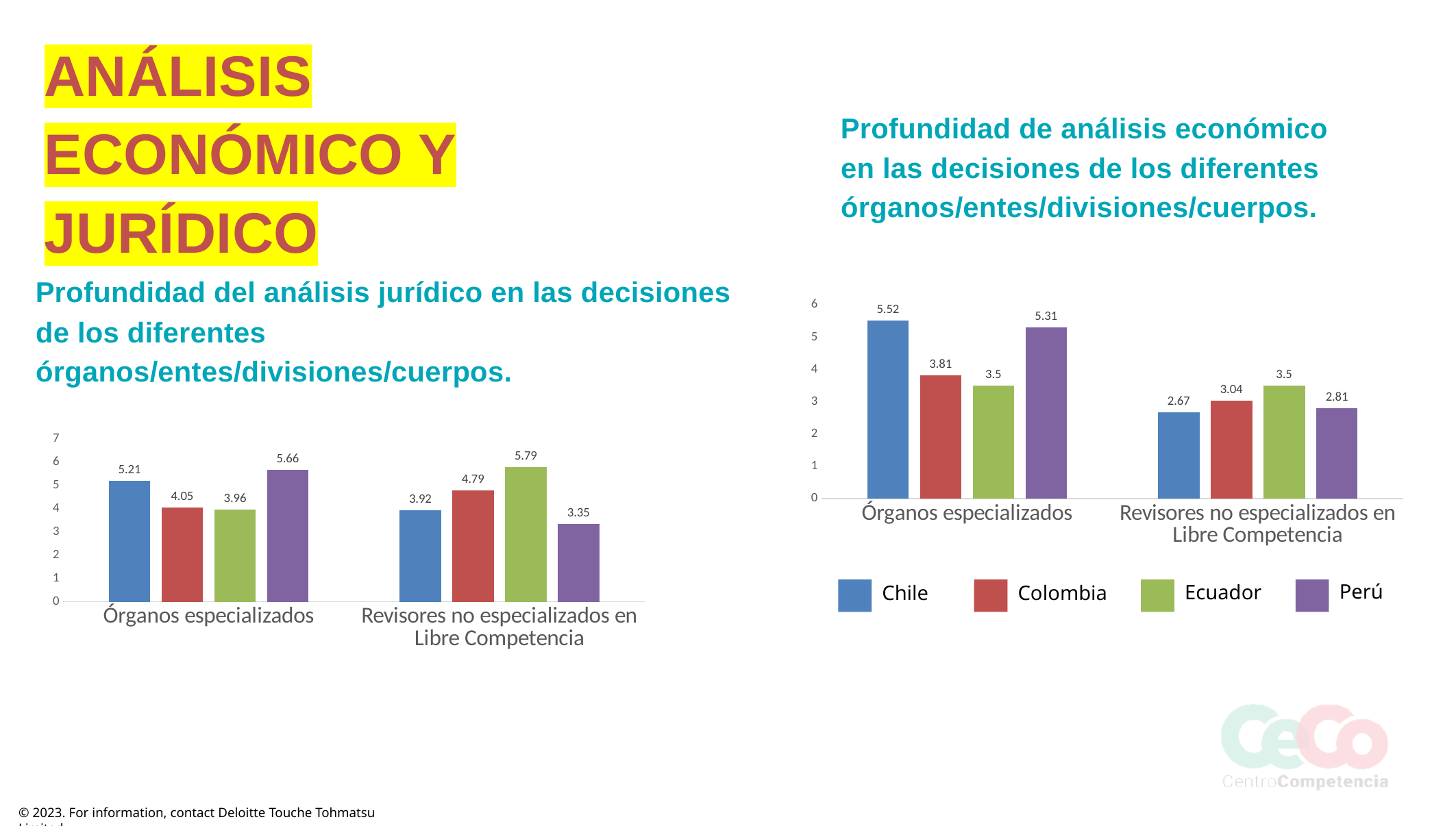
In the chart on the left (Profundidad del análisis jurídico), is the blue bar in Órganos especializados larger or smaller than the blue bar in Revisores no especializados en Libre Competencia? Larger What type of chart is shown on the left of the slide? Bar chart In the chart on the right (Profundidad de análisis económico), how many series does the legend list? 4 In the chart on the right (Profundidad de análisis económico), which country has the highest value in the Órganos especializados category? Chile In the chart on the right (Profundidad de análisis económico), which country has the lowest value in the Revisores no especializados en Libre Competencia category? Chile In the chart on the right (Profundidad de análisis económico), what is the difference between Chile's and Perú's values in the Órganos especializados category? 0.21 In the chart on the left (Profundidad del análisis jurídico), what is the value of the green bar in the Revisores no especializados en Libre Competencia category? 5.79 In the chart on the right (Profundidad de análisis económico), what is the value for Chile in the Órganos especializados category? 5.52 In the chart on the right (Profundidad de análisis económico), what is the value for Colombia in the Revisores no especializados en Libre Competencia category? 3.04 In the chart on the left (Profundidad del análisis jurídico), what is the value of the purple bar in the Órganos especializados category? 5.66 In the chart on the left (Profundidad del análisis jurídico), which bar is the lowest in the Revisores no especializados en Libre Competencia category? The purple bar (3.35) In the chart on the left (Profundidad del análisis jurídico), what is the difference between the red bar (4.05) and the green bar (3.96) in the Órganos especializados category? 0.09